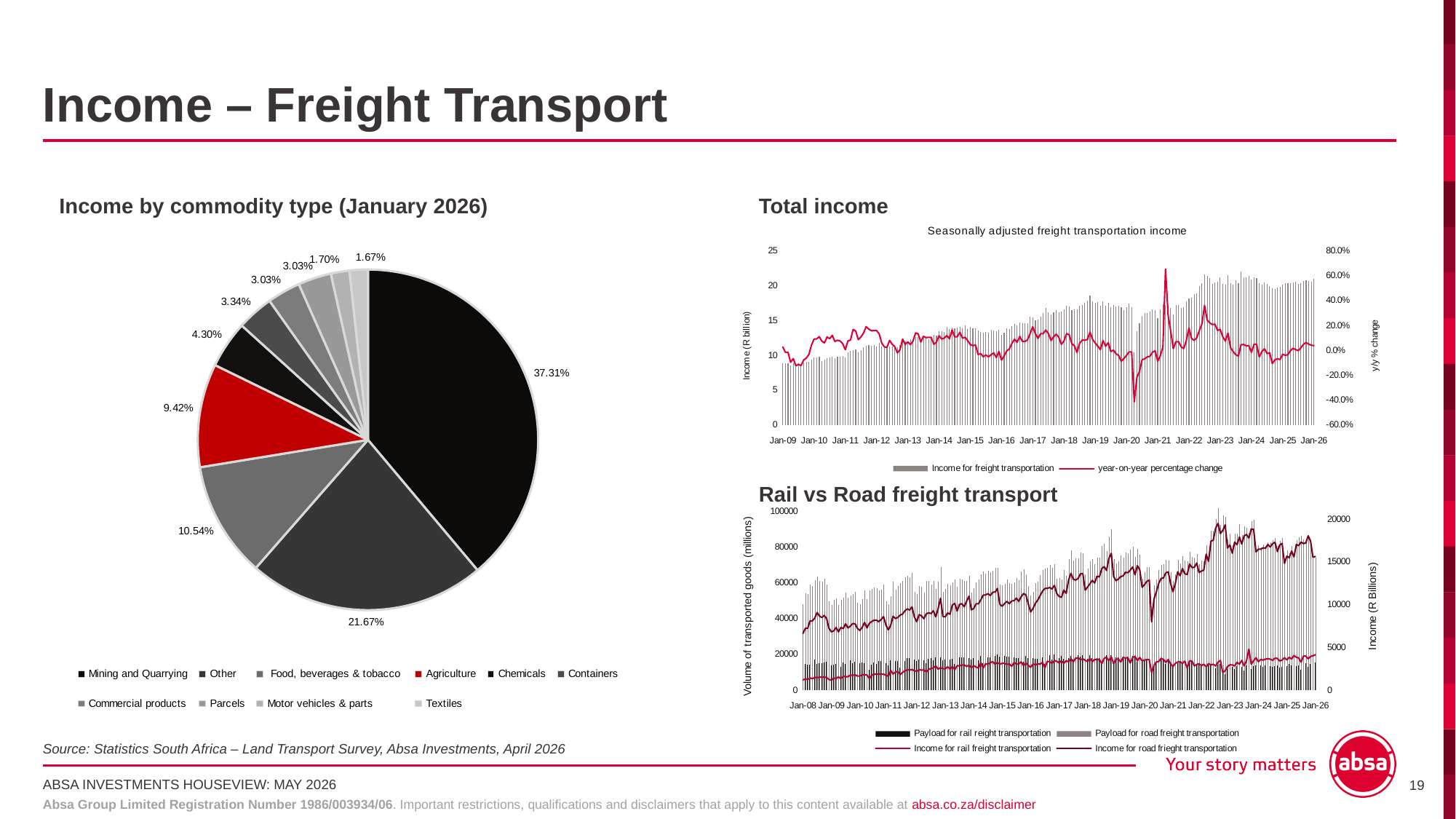
In the 'Total income' chart, do the income for freight transportation bars generally rise or fall from Jan-09 to Jan-26? Rise In the 'Income by commodity type (January 2026)' pie chart, what share does Agriculture have? 9.42% In the 'Income by commodity type (January 2026)' pie chart, what share does Chemicals have? 4.30% In the 'Rail vs Road freight transport' chart, how many series does the legend list? 4 In the 'Income by commodity type (January 2026)' pie chart, which has the larger share: Food, beverages & tobacco or Agriculture? Food, beverages & tobacco In the 'Income by commodity type (January 2026)' pie chart, what is the difference in percentage points between Mining and Quarrying and Other? 15.64 percentage points In the 'Income by commodity type (January 2026)' pie chart, how many commodity types are shown? 10 In the 'Income by commodity type (January 2026)' pie chart, which commodity type has the largest share? Mining and Quarrying What kind of chart is 'Income by commodity type (January 2026)'? Pie chart In the 'Total income' chart, how many series does the legend list? 2 In the 'Rail vs Road freight transport' chart, which line is higher: income for rail freight transportation or income for road freight transportation? Income for road freight transportation In the 'Income by commodity type (January 2026)' pie chart, what share does Mining and Quarrying have? 37.31%